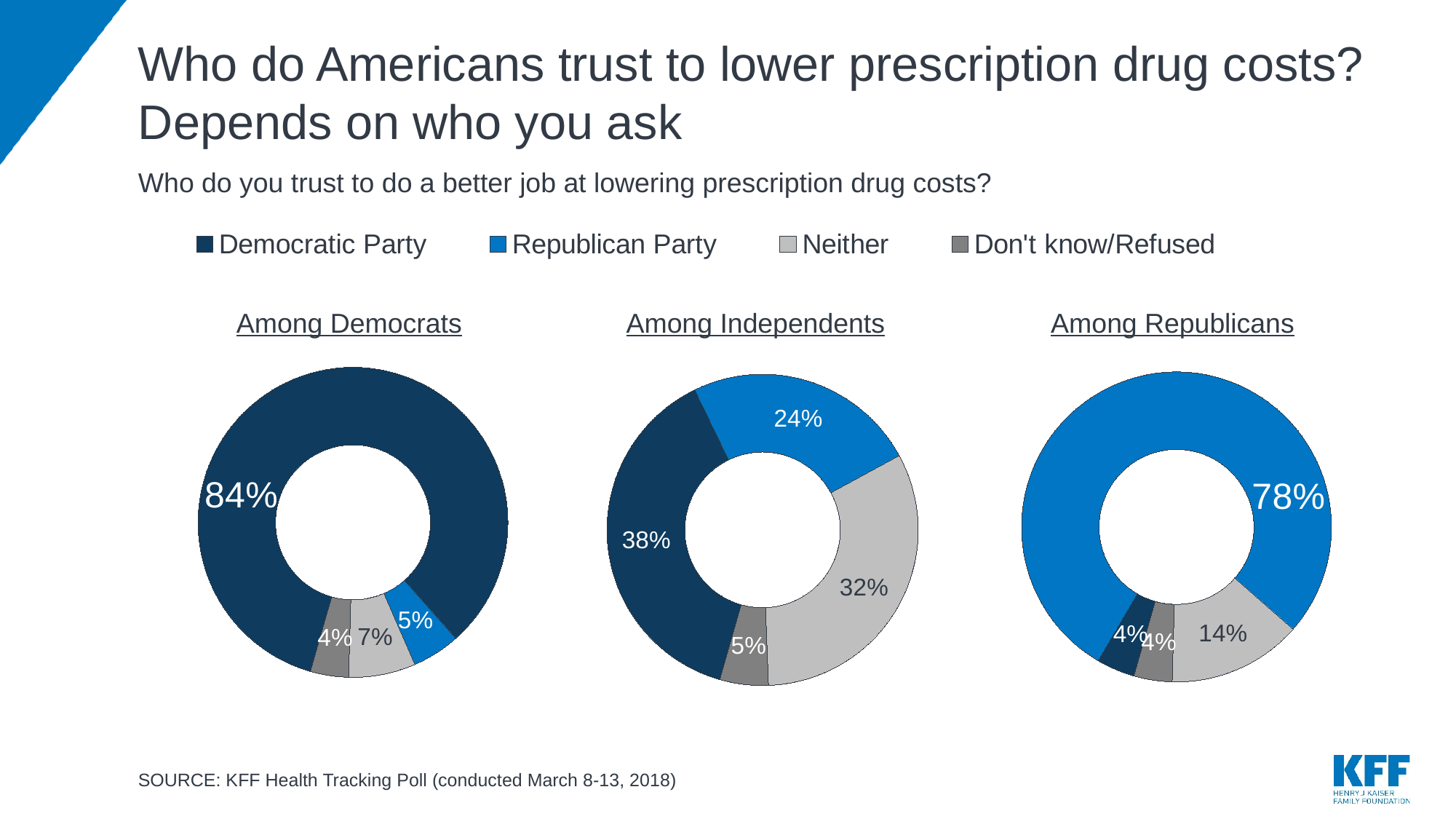
In the 'Among Republicans' chart, what share trusts the Republican Party? 78% In the 'Among Democrats' chart, what share trusts the Democratic Party? 84% In the 'Among Independents' chart, what is the difference between the Democratic Party share and the Republican Party share? 14 percentage points What kind of chart is used on this slide? Donut (pie) chart How many charts are shown on the slide? 3 How many response categories does the legend list? 4 In the 'Among Democrats' chart, what share answered Don't know/Refused? 4% In the 'Among Independents' chart, what share answered Neither? 32% In the 'Among Independents' chart, which response has the largest share? Democratic Party In the 'Among Republicans' chart, what share answered Neither? 14% In the 'Among Democrats' chart, which is larger: the Neither share or the Republican Party share? Neither In the 'Among Independents' chart, which response has the smallest share? Don't know/Refused